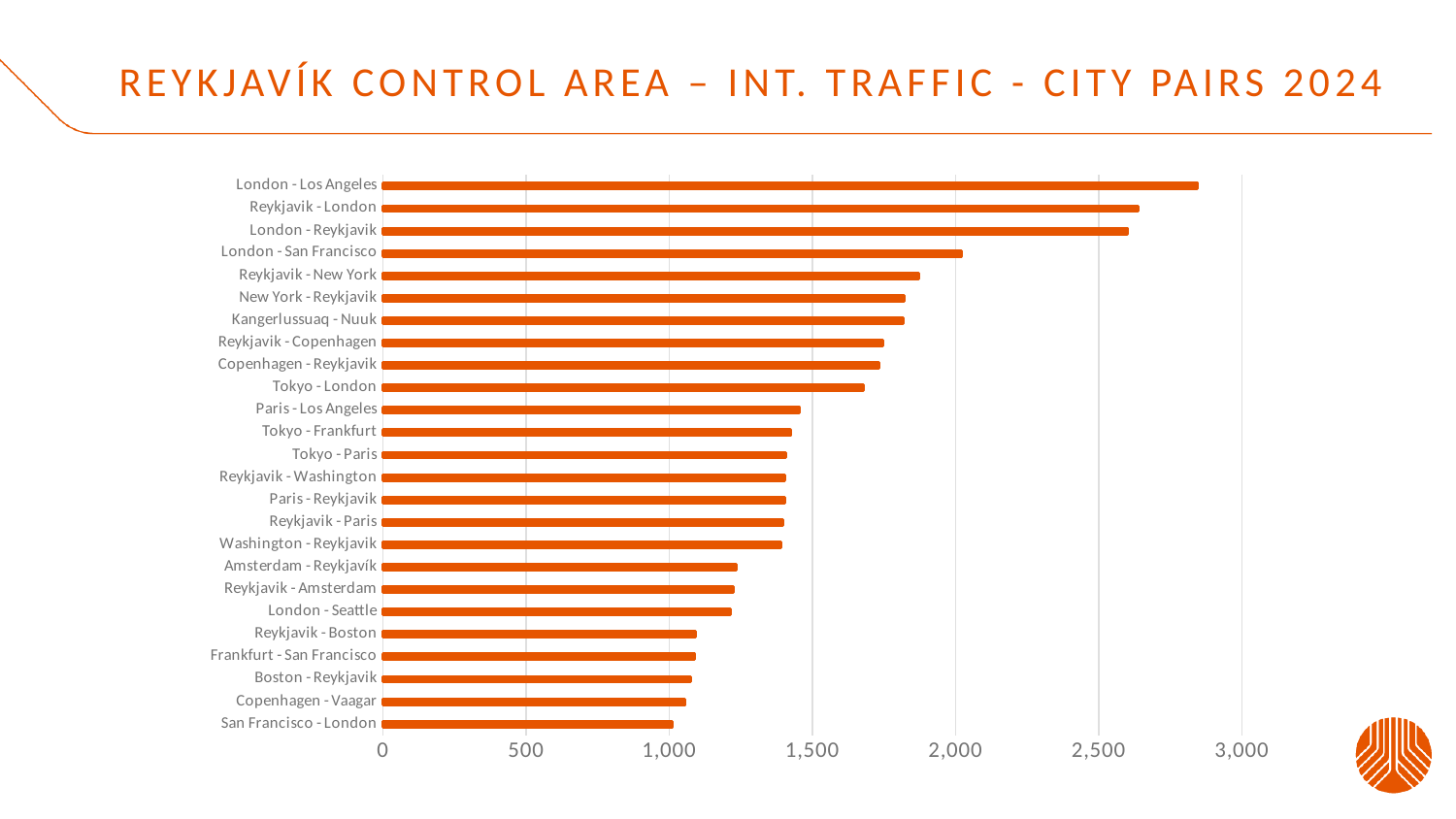
Is the value for Reykjavik - Boston greater or less than 1,000? greater Is the value for London - Los Angeles greater or less than 2,500? greater Which city pair has the highest value in the chart? London - Los Angeles How many city pairs are plotted in the chart? 25 Which has the larger value, London - Seattle or Reykjavik - Boston? London - Seattle What is the title of the chart on the slide? Reykjavík Control Area – Int. Traffic - City Pairs 2024 Which has the larger value, Tokyo - London or Paris - Los Angeles? Tokyo - London What kind of chart is shown on the slide? Bar chart Which city pair has the lowest value in the chart? San Francisco - London Is the value for Tokyo - London greater or less than 2,000? less